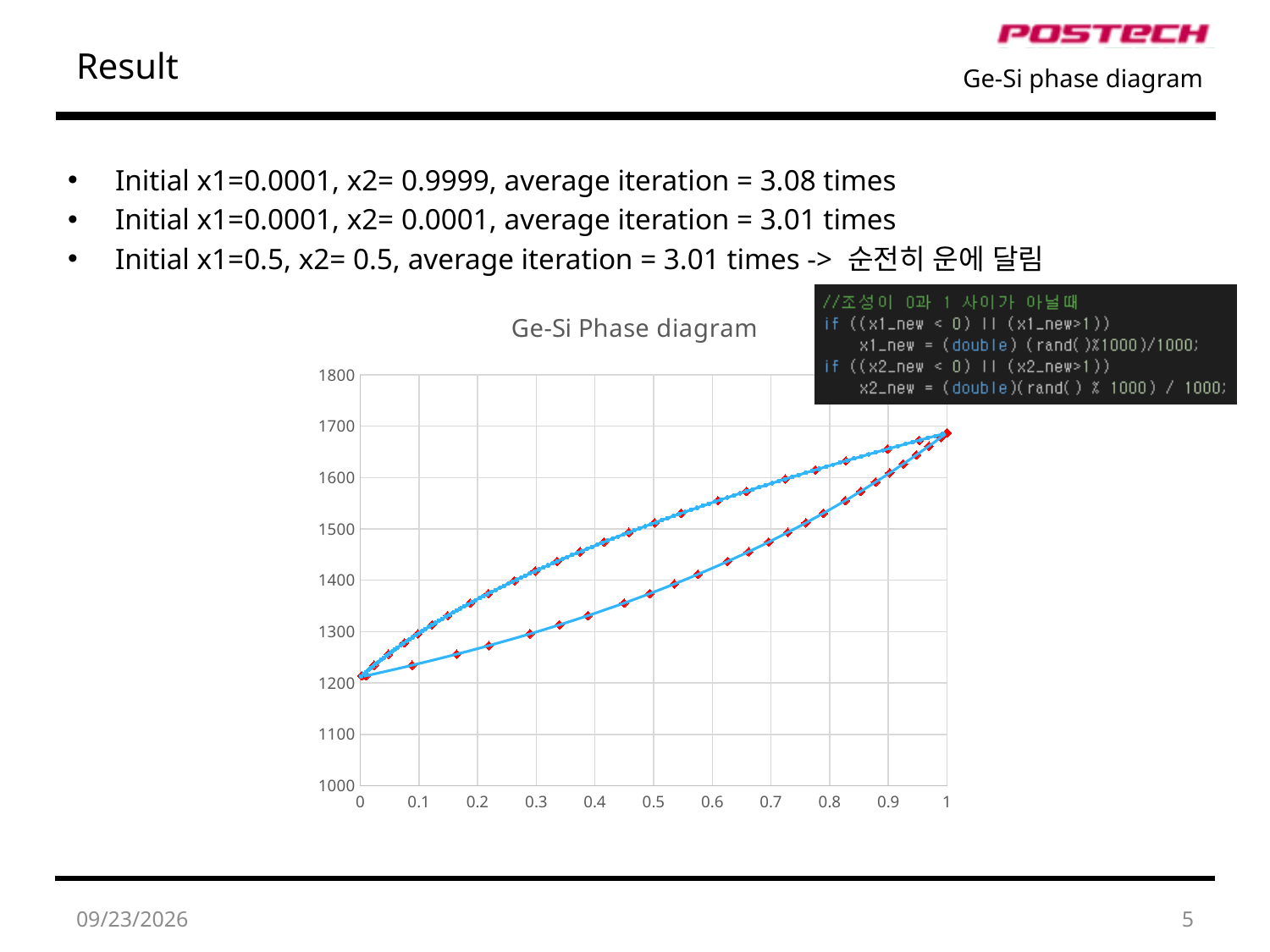
Is the value of the lower curve at x = 0.2 greater or less than 1300? less How many curves are plotted on the chart? 2 What is the range of the y axis on the chart? 1000 to 1800 Is the value where the two curves meet at x = 0 greater or less than 1300? less Is the value of the lower curve at x = 0.8 greater or less than 1500? greater What kind of chart is shown on the slide? Line chart (scatter with lines) What is the title of the chart? Ge-Si Phase diagram Do the plotted curves rise or fall as the x value increases from 0 to 1? Rise At x = 0.5, which curve has the larger value, the upper curve or the lower curve? The upper curve